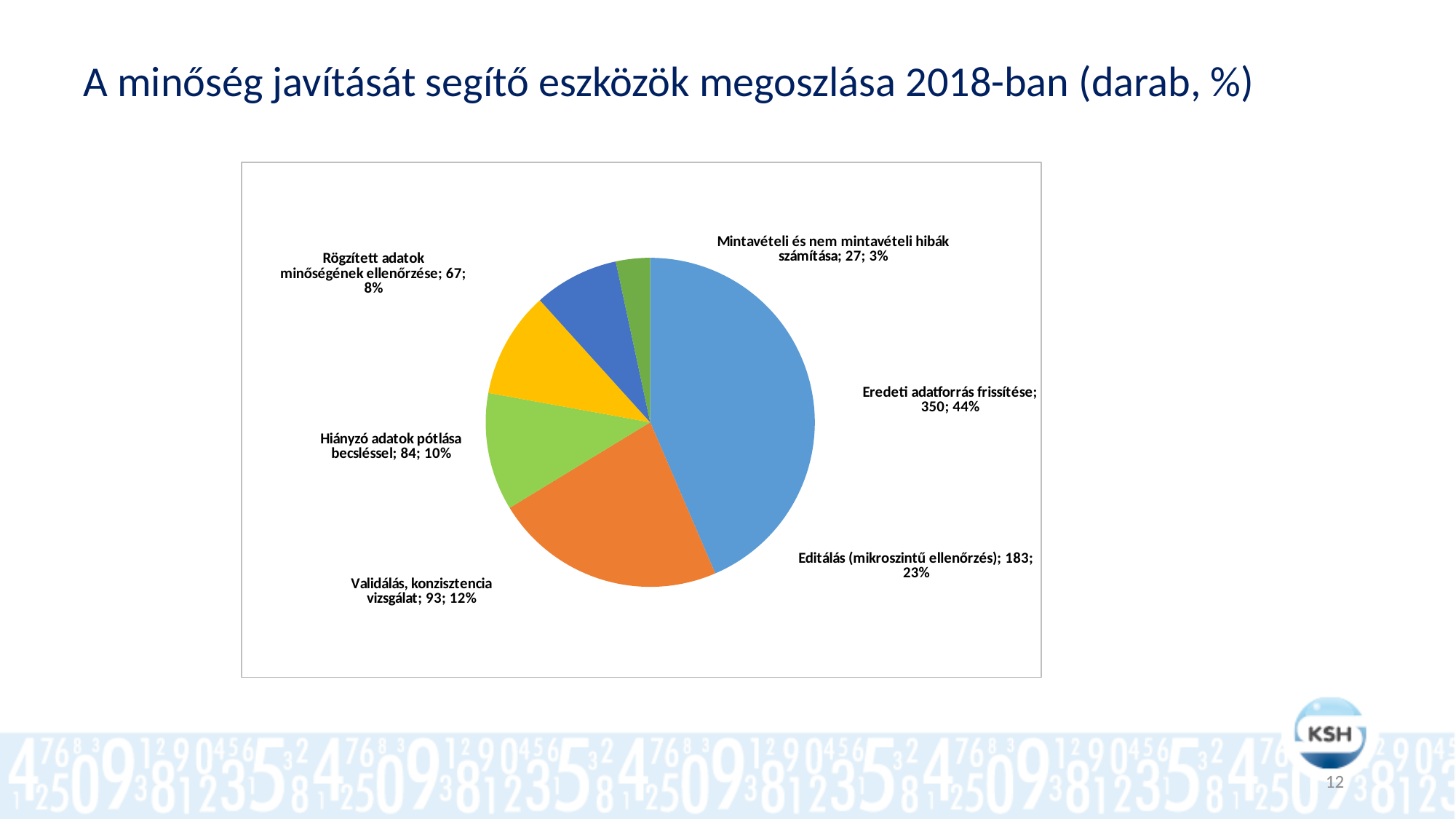
Which is larger: the count for 'Validálás, konzisztencia vizsgálat' or for 'Hiányzó adatok pótlása becsléssel'? Validálás, konzisztencia vizsgálat What share of the pie does 'Rögzített adatok minőségének ellenőrzése' represent? 8% What is the count for 'Editálás (mikroszintű ellenőrzés)'? 183 What kind of chart is shown on the slide? pie chart Which category has the smallest slice? Mintavételi és nem mintavételi hibák számítása Which category has the largest slice? Eredeti adatforrás frissítése What is the title of the slide containing the chart? A minőség javítását segítő eszközök megoszlása 2018-ban (darab, %) How many slices does the pie chart have? 6 What is the difference between the counts for 'Eredeti adatforrás frissítése' and 'Editálás (mikroszintű ellenőrzés)'? 167 What is the count for 'Eredeti adatforrás frissítése'? 350 What share of the pie does 'Validálás, konzisztencia vizsgálat' represent? 12% What is the count for 'Hiányzó adatok pótlása becsléssel'? 84